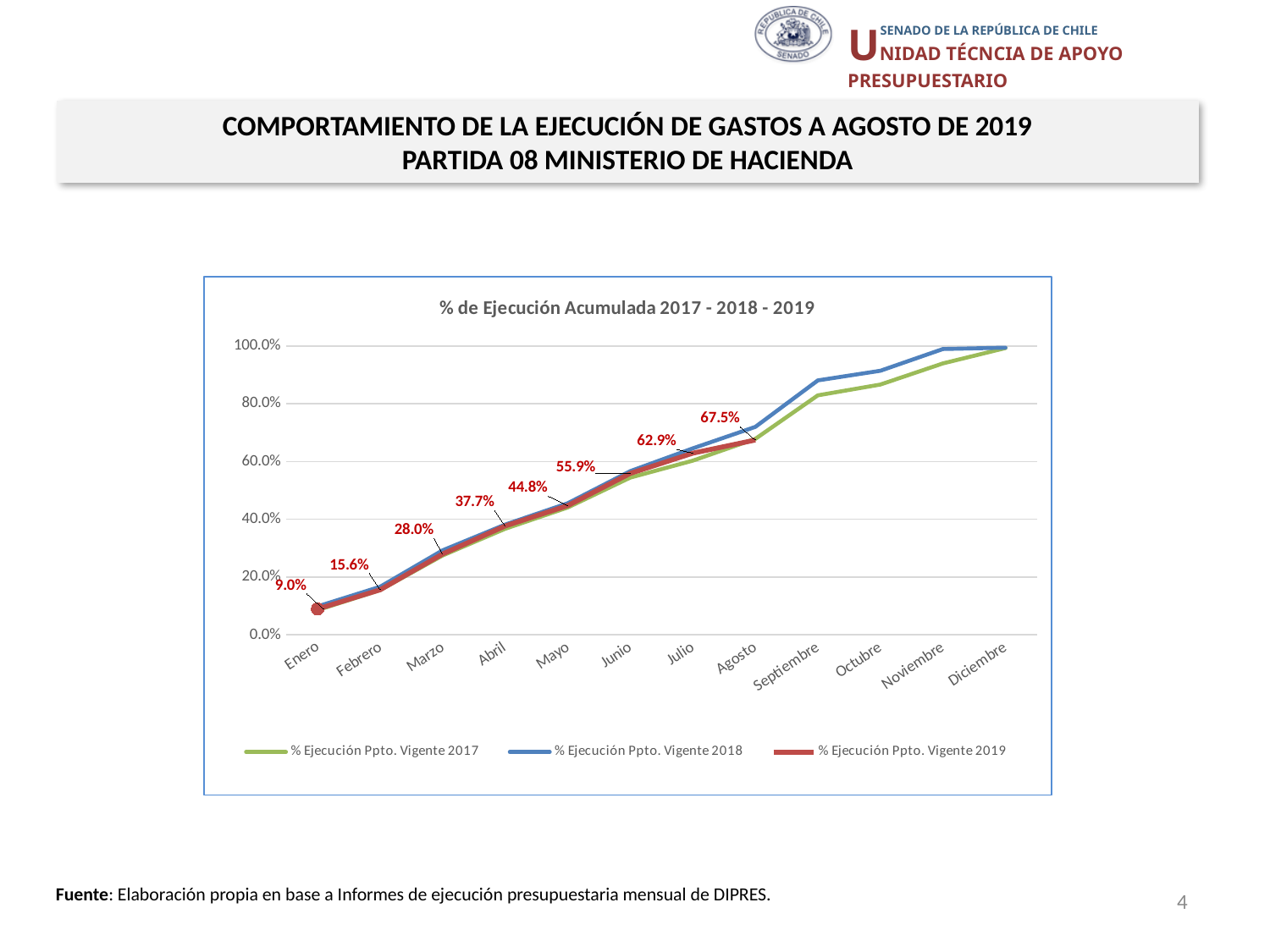
What is the value for % Ejecución Ppto. Vigente 2019 in Agosto? 67.5% What kind of chart is shown? Line chart How many series does the legend list? 3 Is the value for % Ejecución Ppto. Vigente 2018 in Septiembre greater or less than 80.0%? greater What is the value for % Ejecución Ppto. Vigente 2019 in Marzo? 28.0% Is the value for % Ejecución Ppto. Vigente 2017 in Octubre greater or less than 100.0%? less What is the value for % Ejecución Ppto. Vigente 2019 in Mayo? 44.8% What is the value for % Ejecución Ppto. Vigente 2019 in Enero? 9.0% What is the difference between the 2019 values for Agosto and Julio? 4.6% How many months are shown on the x axis? 12 What is the difference between the 2019 values for Junio and Enero? 46.9% Which month has the highest labelled value for the 2019 series? Agosto